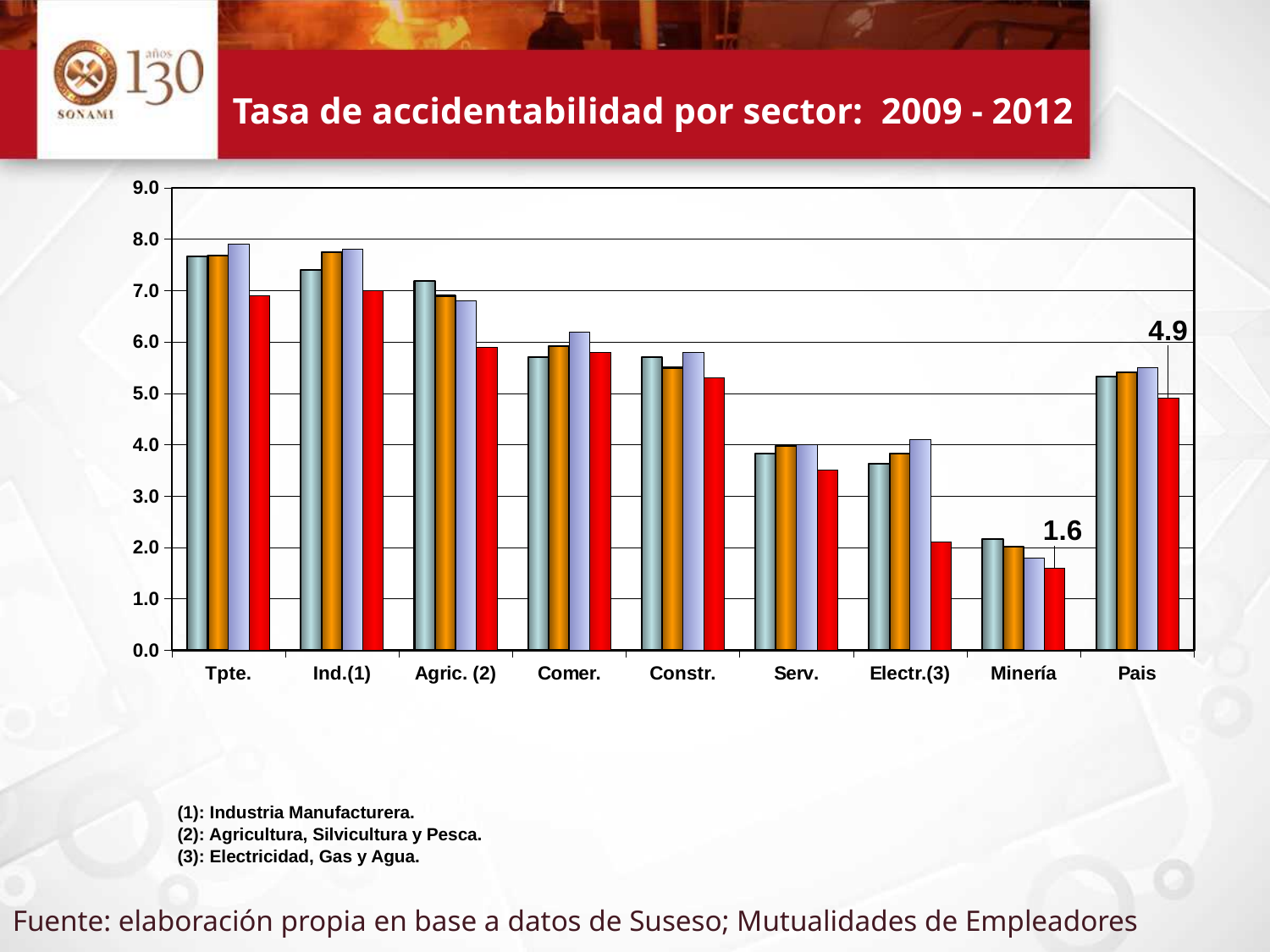
How many bars are plotted for each sector category? 4 Which sector has lower bars, Minería or Electr.(3)? Minería What is the difference between the labelled Pais value (4.9) and the labelled Minería value (1.6)? 3.3 Are the values for Tpte. greater or less than 6.0? greater What value is labelled on the Minería group of bars? 1.6 What value is labelled on the Pais group of bars? 4.9 What kind of chart is shown on the slide? bar chart Which sector has the lowest accident rates in the chart? Minería Which sector has higher bars, Tpte. or Serv.? Tpte. What is the title of the chart? Tasa de accidentabilidad por sector: 2009 - 2012 Are the values for Serv. greater or less than 5.0? less How many sector categories are shown on the x axis of the chart? 9